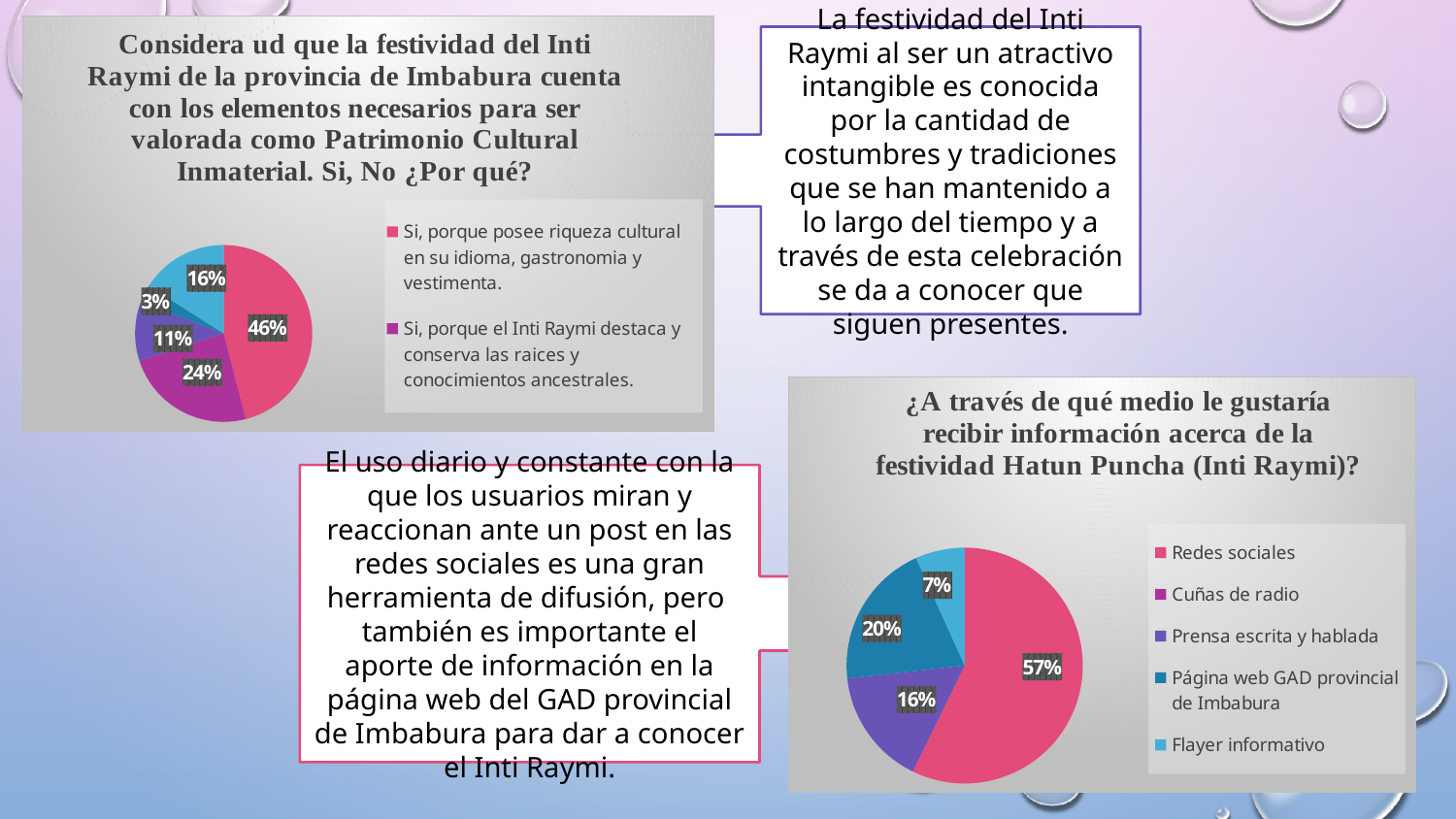
In the pie chart about the medium for receiving information about Hatun Puncha (Inti Raymi), which is larger: 'Página web GAD provincial de Imbabura' or 'Prensa escrita y hablada'? Página web GAD provincial de Imbabura In the pie chart about the medium for receiving information about Hatun Puncha (Inti Raymi), what percentage is shown for 'Página web GAD provincial de Imbabura'? 20% In the pie chart at the top left about whether the Inti Raymi festivity has the elements to be valued as Patrimonio Cultural Inmaterial, what percentage is shown for 'Si, porque el Inti Raymi destaca y conserva las raices y conocimientos ancestrales'? 24% In the pie chart about the medium for receiving information about Hatun Puncha (Inti Raymi), what is the difference in percentage points between 'Redes sociales' and 'Página web GAD provincial de Imbabura'? 37 percentage points What type of chart is used on the slide for the question about the medium for receiving information about Hatun Puncha (Inti Raymi)? Pie chart In the pie chart about the medium for receiving information about Hatun Puncha (Inti Raymi), what percentage is shown for 'Flayer informativo'? 7% In the pie chart titled '¿A través de qué medio le gustaría recibir información acerca de la festividad Hatun Puncha (Inti Raymi)?', what percentage is shown for 'Redes sociales'? 57% How many slices does the pie chart at the top left about the Inti Raymi festivity as Patrimonio Cultural Inmaterial have? 5 In the pie chart at the top left about whether the Inti Raymi festivity has the elements to be valued as Patrimonio Cultural Inmaterial, what percentage is shown for 'Si, porque posee riqueza cultural en su idioma, gastronomia y vestimenta'? 46% How many entries does the legend of the pie chart about the medium for receiving information about Hatun Puncha (Inti Raymi) list? 5 In the pie chart about the medium for receiving information about Hatun Puncha (Inti Raymi), what percentage is shown for 'Prensa escrita y hablada'? 16% In the pie chart about the medium for receiving information about Hatun Puncha (Inti Raymi), which category has the largest share? Redes sociales